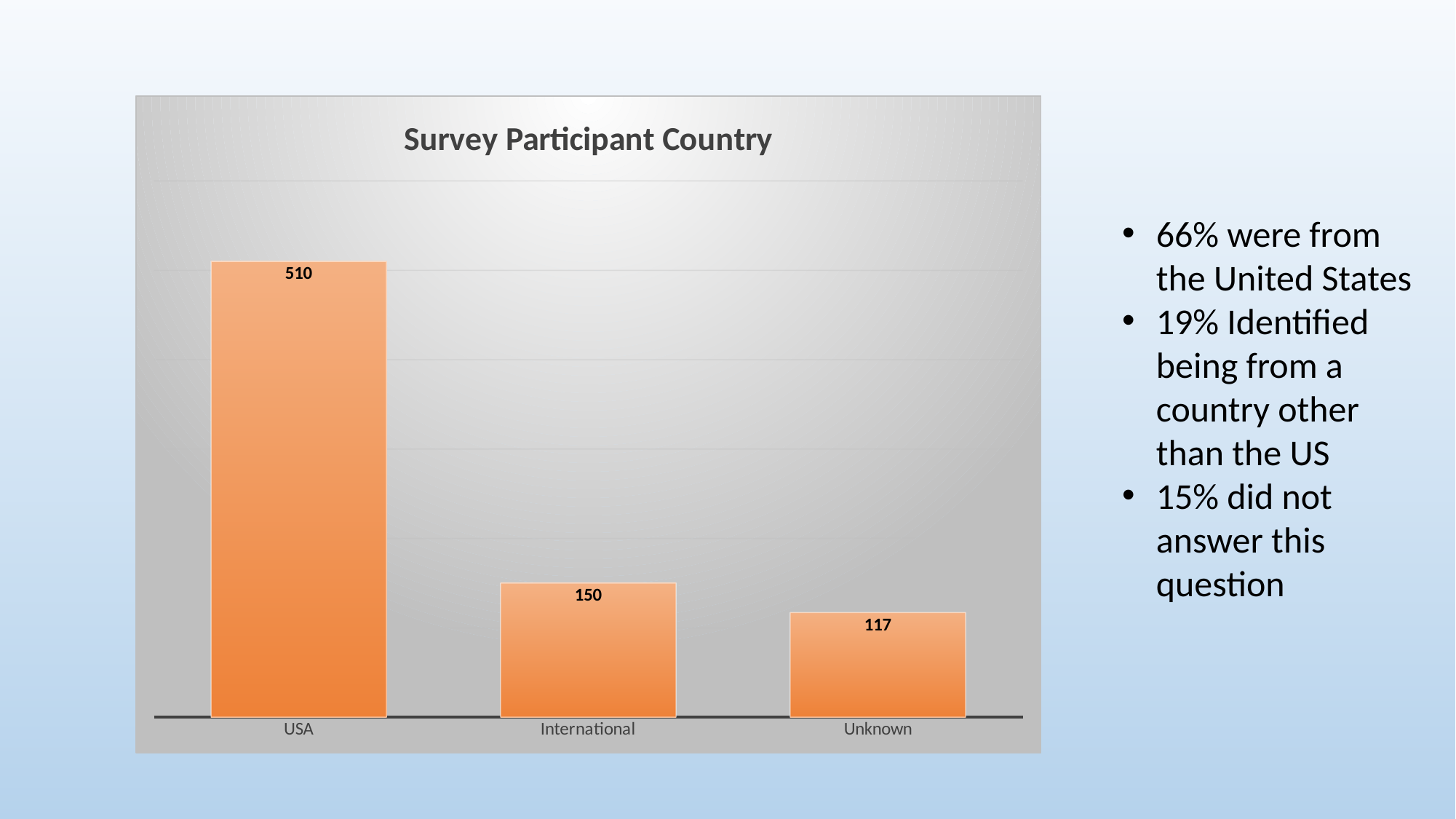
What is the value for Unknown in the Survey Participant Country chart? 117 What is the value for USA in the Survey Participant Country chart? 510 What is the value for International in the Survey Participant Country chart? 150 What kind of chart is shown on the slide? Bar chart Which is larger, the value for International or the value for Unknown? International Which category has the lowest value in the Survey Participant Country chart? Unknown What is the title of the chart on the slide? Survey Participant Country What is the difference between the International and Unknown values? 33 Which category has the highest value in the Survey Participant Country chart? USA How many categories are shown in the Survey Participant Country chart? 3 Do the values rise or fall from left to right across the categories? Fall What is the difference between the USA and International values? 360